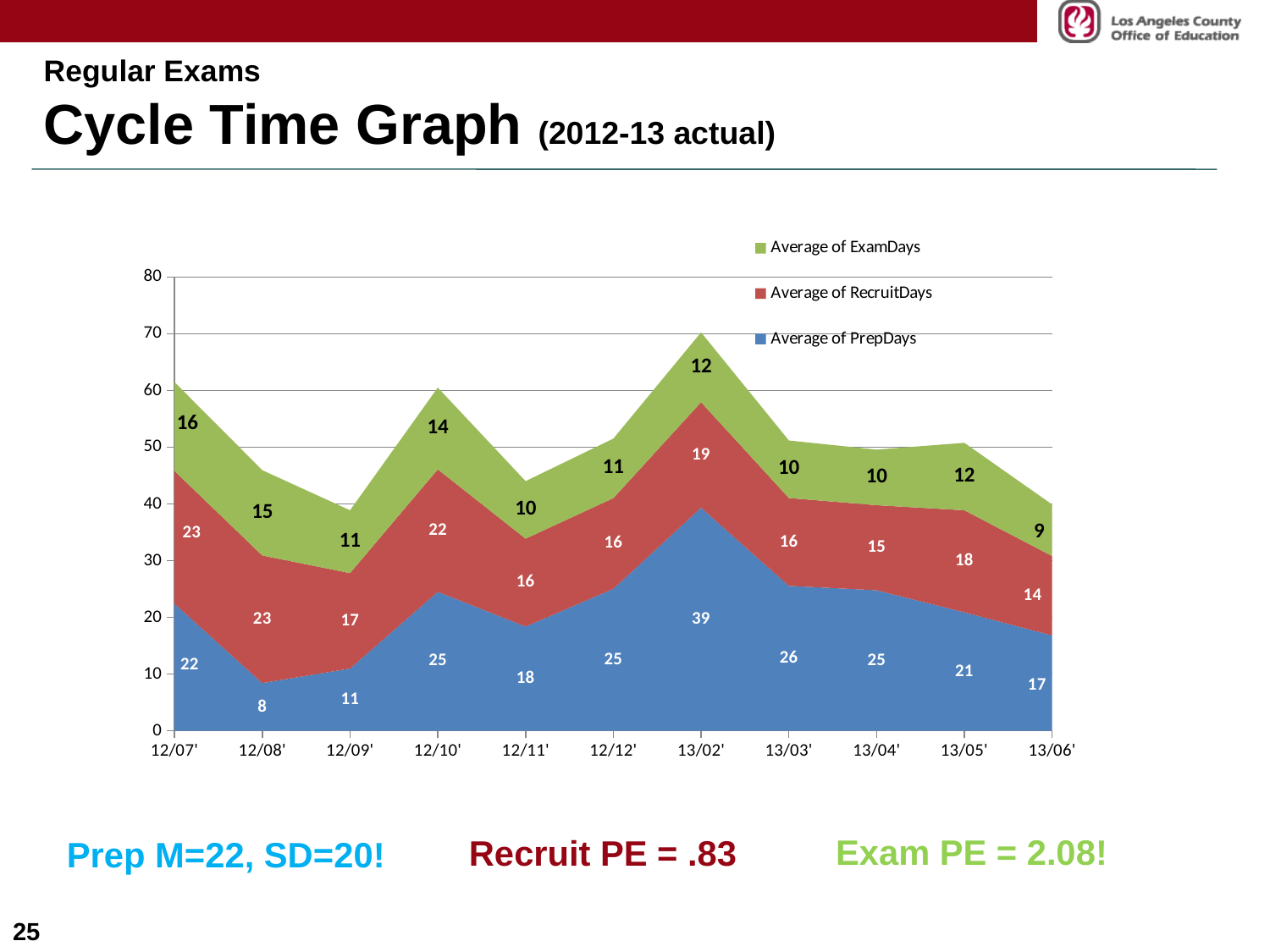
Which period has the lowest Average of PrepDays? 12/08' Which period has the highest Average of PrepDays? 13/02' Which is larger, the Average of RecruitDays for 12/10' or for 13/04'? 12/10' What is the Average of ExamDays value for 13/06'? 9 What is the difference between the Average of PrepDays for 13/02' and 12/08'? 31 What is the total of the stacked values for 12/09'? 39 What is the Average of RecruitDays value for 12/07'? 23 How many periods are shown on the x axis? 11 How many series does the legend list? 3 What kind of chart is shown on the slide? Stacked area chart What is the total of the stacked values for 13/02'? 70 What is the Average of PrepDays value for 13/02'? 39